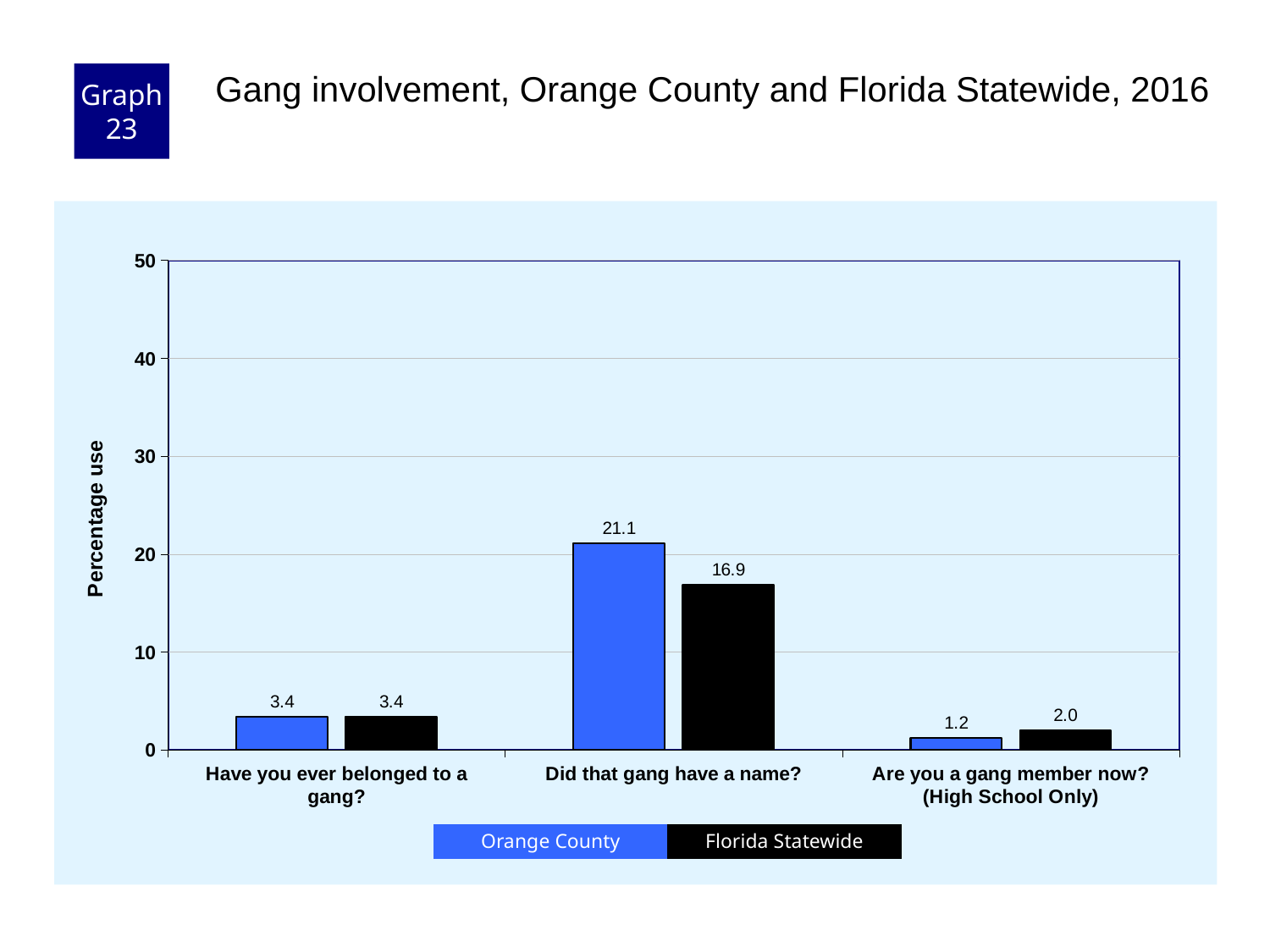
Which question has the lowest Florida Statewide value? Are you a gang member now? (High School Only) What is the Florida Statewide value for "Are you a gang member now? (High School Only)"? 2.0 What is the label of the y axis? Percentage use Which question has the highest Orange County value? Did that gang have a name? How many question categories are shown on the x axis? 3 What is the difference between the Orange County and Florida Statewide values for "Did that gang have a name?"? 4.2 For "Are you a gang member now? (High School Only)", which is larger: Orange County or Florida Statewide? Florida Statewide What is the Orange County value for "Did that gang have a name?"? 21.1 Is the Florida Statewide value for "Did that gang have a name?" greater or less than 20? less What kind of chart is shown on the slide? bar chart How many series does the legend list? 2 What is the Orange County value for "Have you ever belonged to a gang?"? 3.4